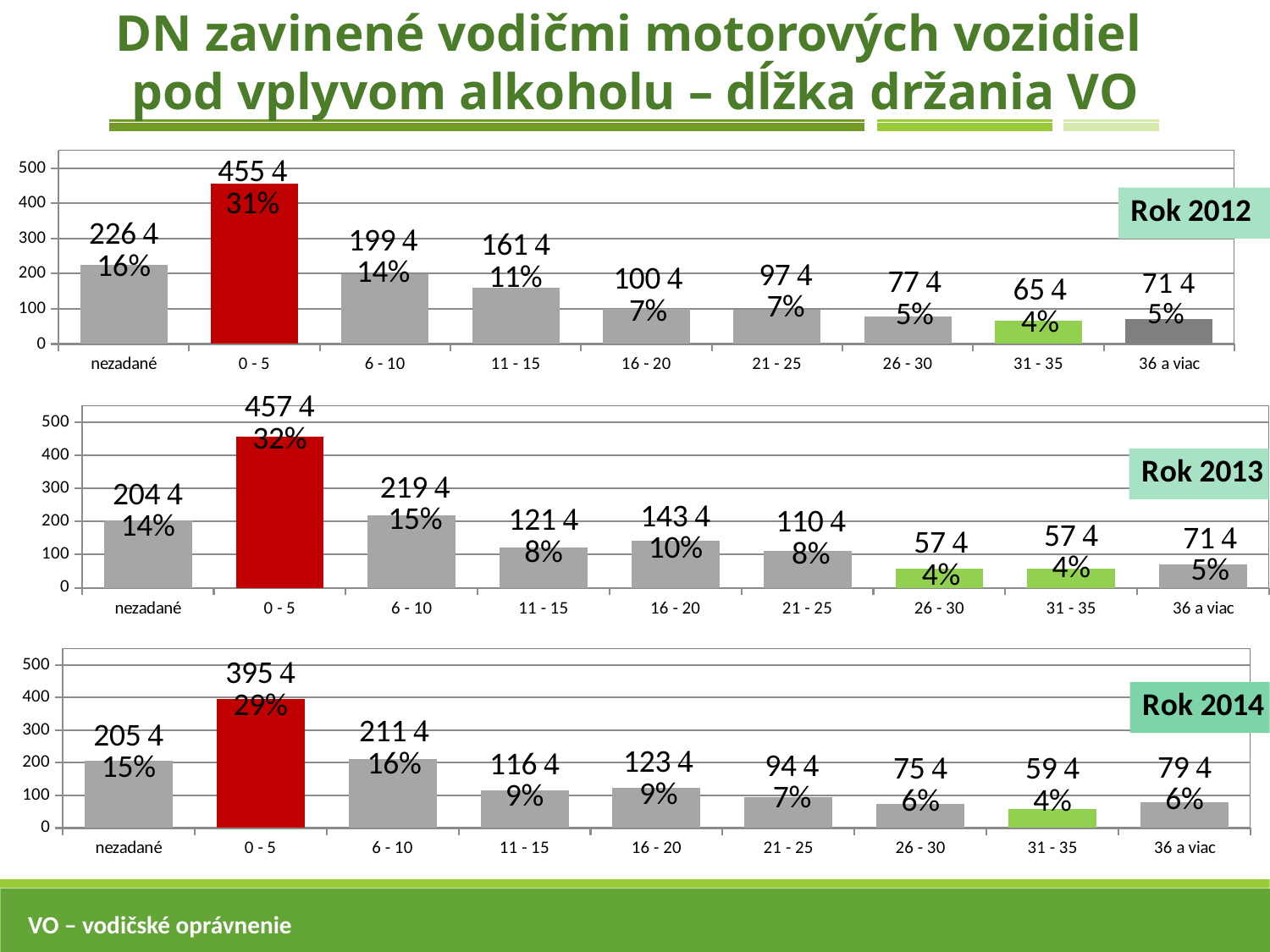
In the Rok 2012 chart, what percentage is shown for the 0 - 5 category? 31% In the Rok 2014 chart, what percentage is shown for the nezadané category? 15% In the Rok 2012 chart, which category has the highest bar? 0 - 5 In the Rok 2012 chart, is the value for 21 - 25 greater or less than 200? less What kind of chart is the Rok 2014 chart? bar chart In the Rok 2014 chart, which category has the lowest percentage? 31 - 35 In the Rok 2013 chart, which categories share the lowest percentage? 26 - 30 and 31 - 35 In the Rok 2014 chart, is the value for 0 - 5 greater or less than 300? greater In the Rok 2013 chart, which is larger, the value for 16 - 20 or the value for 11 - 15? 16 - 20 In the Rok 2013 chart, what percentage is shown for the 6 - 10 category? 15% In the Rok 2012 chart, what is the difference in percentage points between the 0 - 5 and nezadané categories? 15 How many categories are shown on the x axis of the Rok 2013 chart? 9